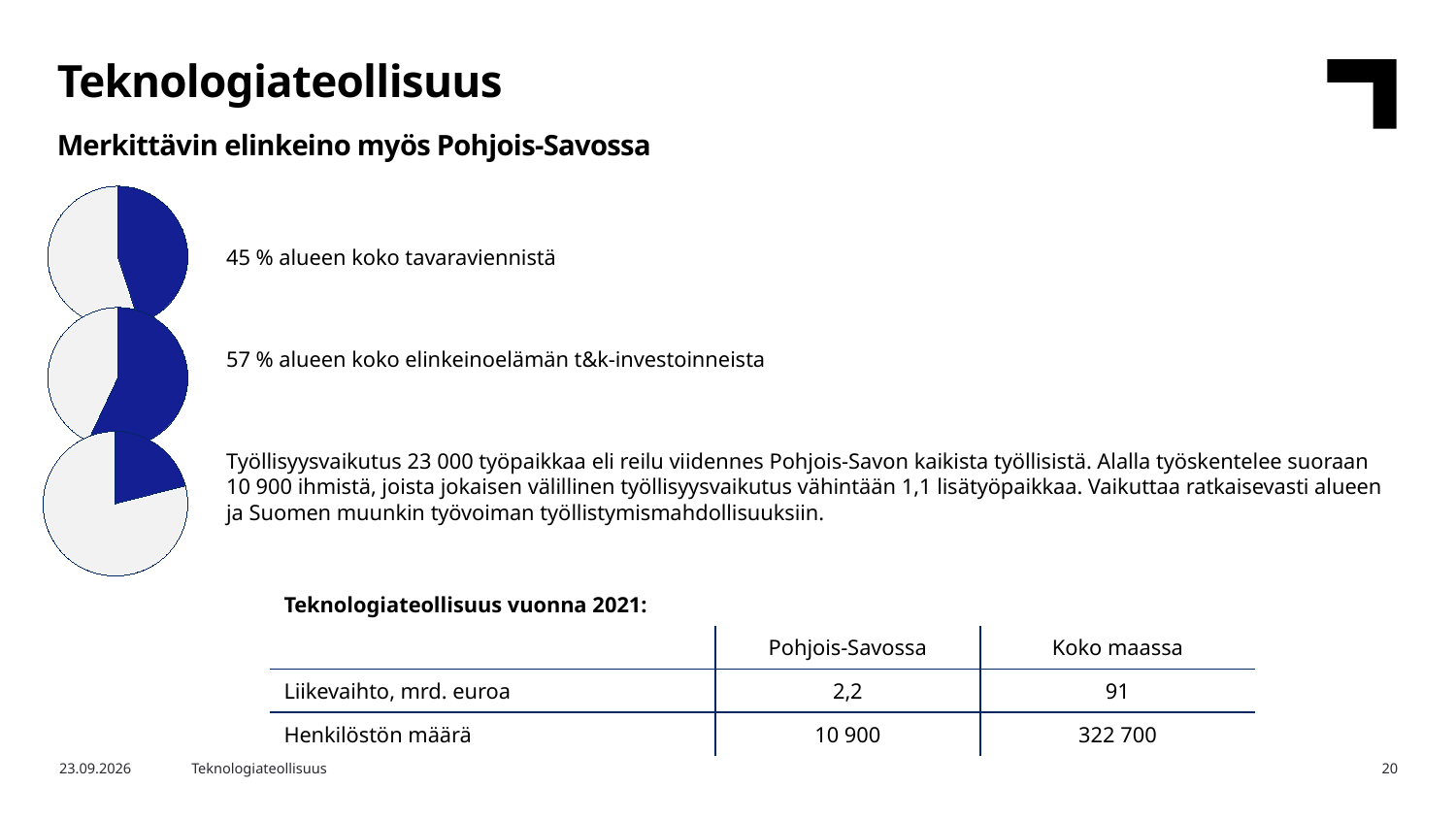
How many slices does each pie chart have? 2 Which of the three pie charts has the largest blue slice? The middle one What colour is the highlighted slice in each pie chart? Blue What kind of charts are shown on the left side of the slide? Pie charts Which pie chart has the larger blue slice, the top one or the middle one? The middle one How many pie charts are on the slide? 3 In the middle pie chart, what share of the region's business R&D investments (t&k-investoinnit) does the blue slice represent? 57 % Is the blue slice in the middle pie chart larger or smaller than half of the pie? Larger Is the blue slice in the bottom pie chart larger or smaller than half of the pie? Smaller In the top pie chart, what share of the region's total goods exports (tavaravienti) does the blue slice represent? 45 % What does the bottom pie chart illustrate, according to the text next to it? Employment impact of 23 000 jobs, just over a fifth of all employed in Pohjois-Savo Which of the three pie charts has the smallest blue slice? The bottom one